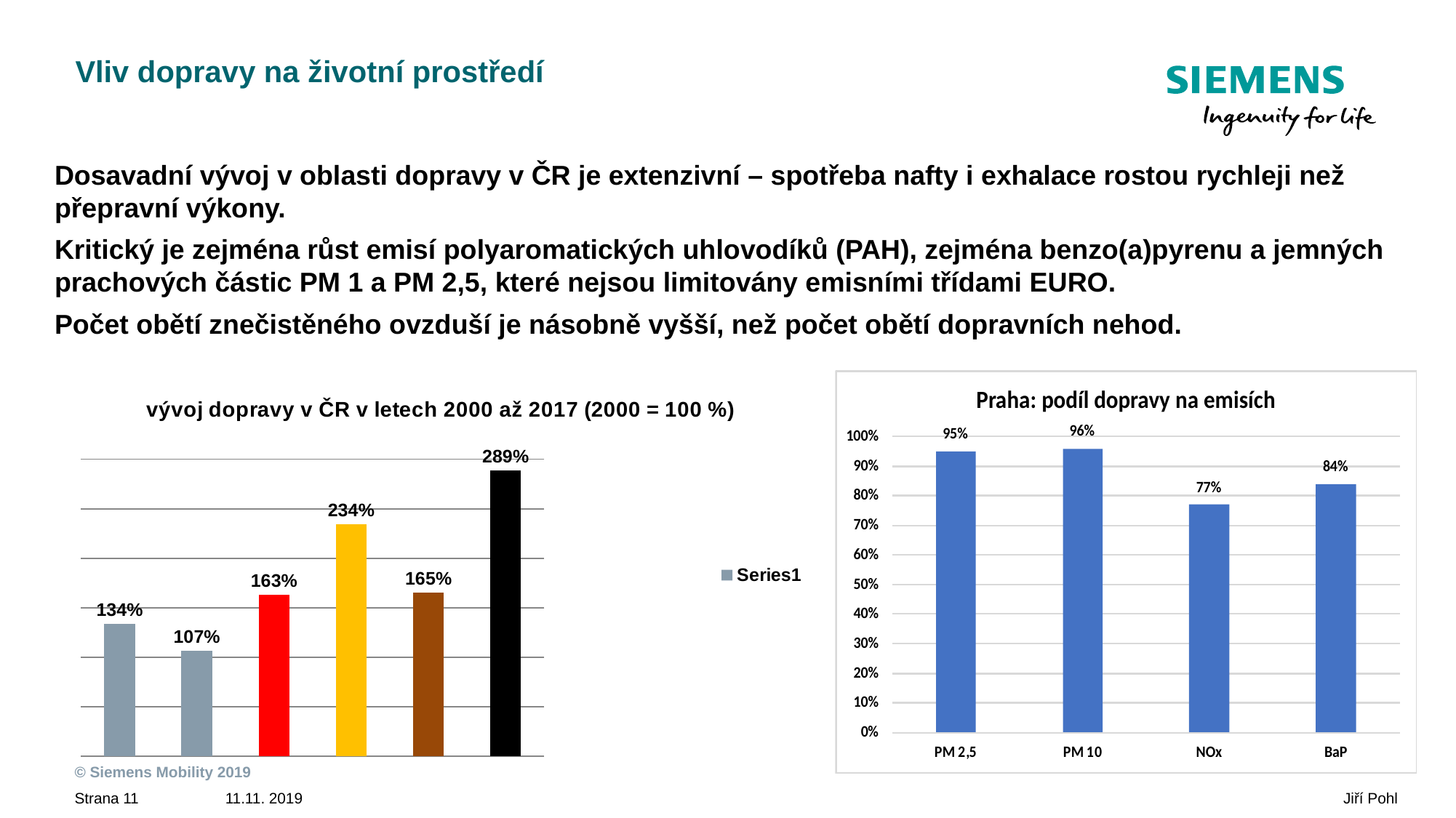
In the chart 'Praha: podíl dopravy na emisích', which category has the highest value? PM 10 In the chart 'Praha: podíl dopravy na emisích', what is the value for BaP? 84% In the chart 'vývoj dopravy v ČR v letech 2000 až 2017 (2000 = 100 %)', how many bars are plotted? 6 In the chart 'Praha: podíl dopravy na emisích', which category has the lowest value? NOx In the chart 'Praha: podíl dopravy na emisích', what is the difference between the values for PM 10 and NOx? 19% In the chart 'Praha: podíl dopravy na emisích', which is larger, the value for BaP or the value for NOx? BaP In the chart 'Praha: podíl dopravy na emisích', what is the value for PM 2,5? 95% In the chart 'vývoj dopravy v ČR v letech 2000 až 2017 (2000 = 100 %)', what is the lowest value shown? 107% In the chart 'Praha: podíl dopravy na emisích', how many categories are shown on the x axis? 4 In the chart 'Praha: podíl dopravy na emisích', what is the value for NOx? 77% What kind of chart is the chart 'vývoj dopravy v ČR v letech 2000 až 2017 (2000 = 100 %)'? Bar chart In the chart 'vývoj dopravy v ČR v letech 2000 až 2017 (2000 = 100 %)', what is the highest value shown? 289%